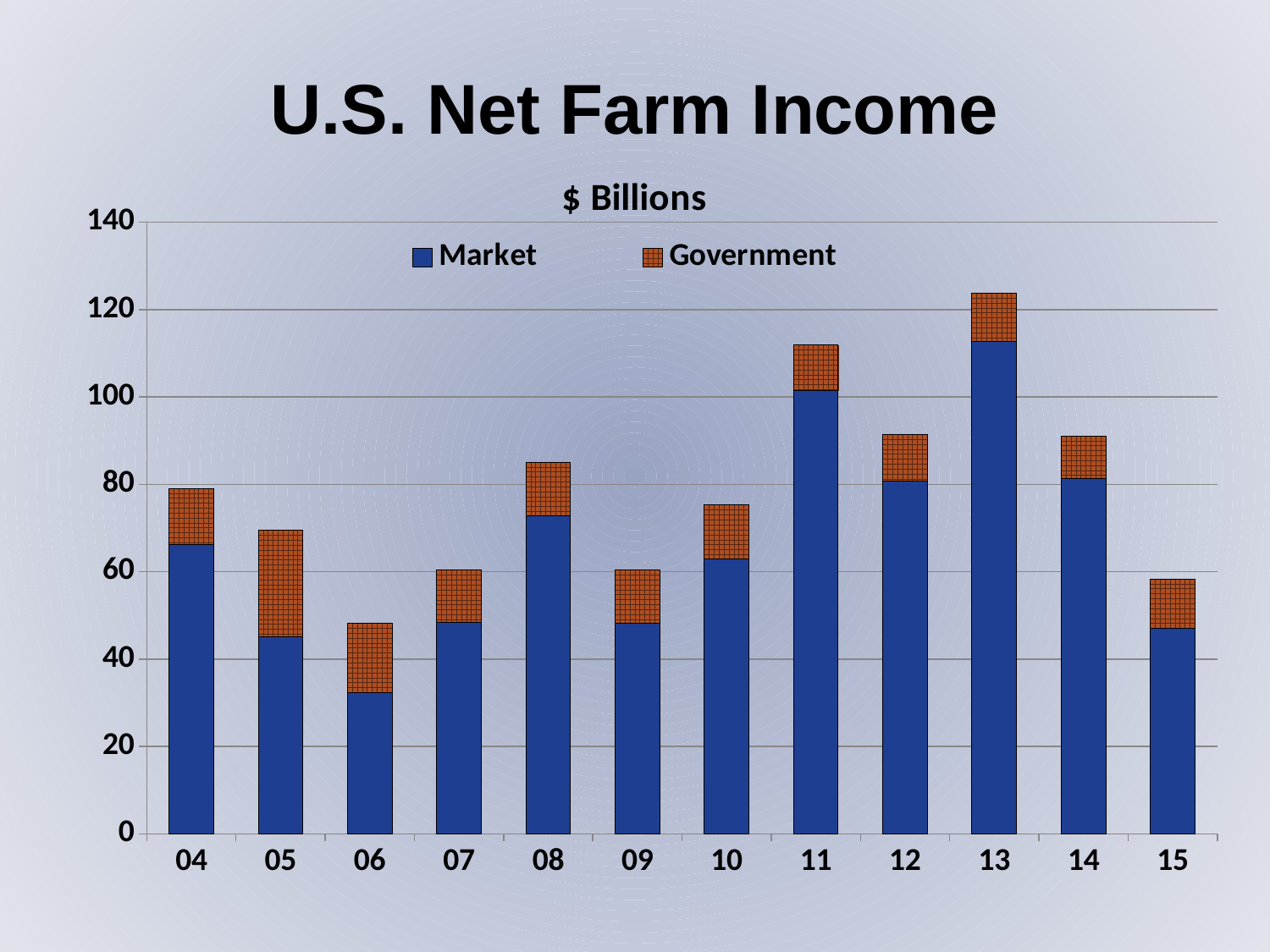
What unit is given in the chart's subtitle? $ Billions Which year has the lowest Market value? 06 Is the total value for 11 greater or less than 100? greater Is the Market value for 13 greater or less than 100? greater Which year has the larger total, 11 or 12? 11 Do the total values rise or fall from 13 to 15? fall How many years are shown on the x axis? 12 Which year has the lowest total net farm income? 06 What kind of chart is shown on the slide? bar chart How many series does the legend list? 2 Is the total value for 06 greater or less than 60? less Which year has the highest total net farm income? 13